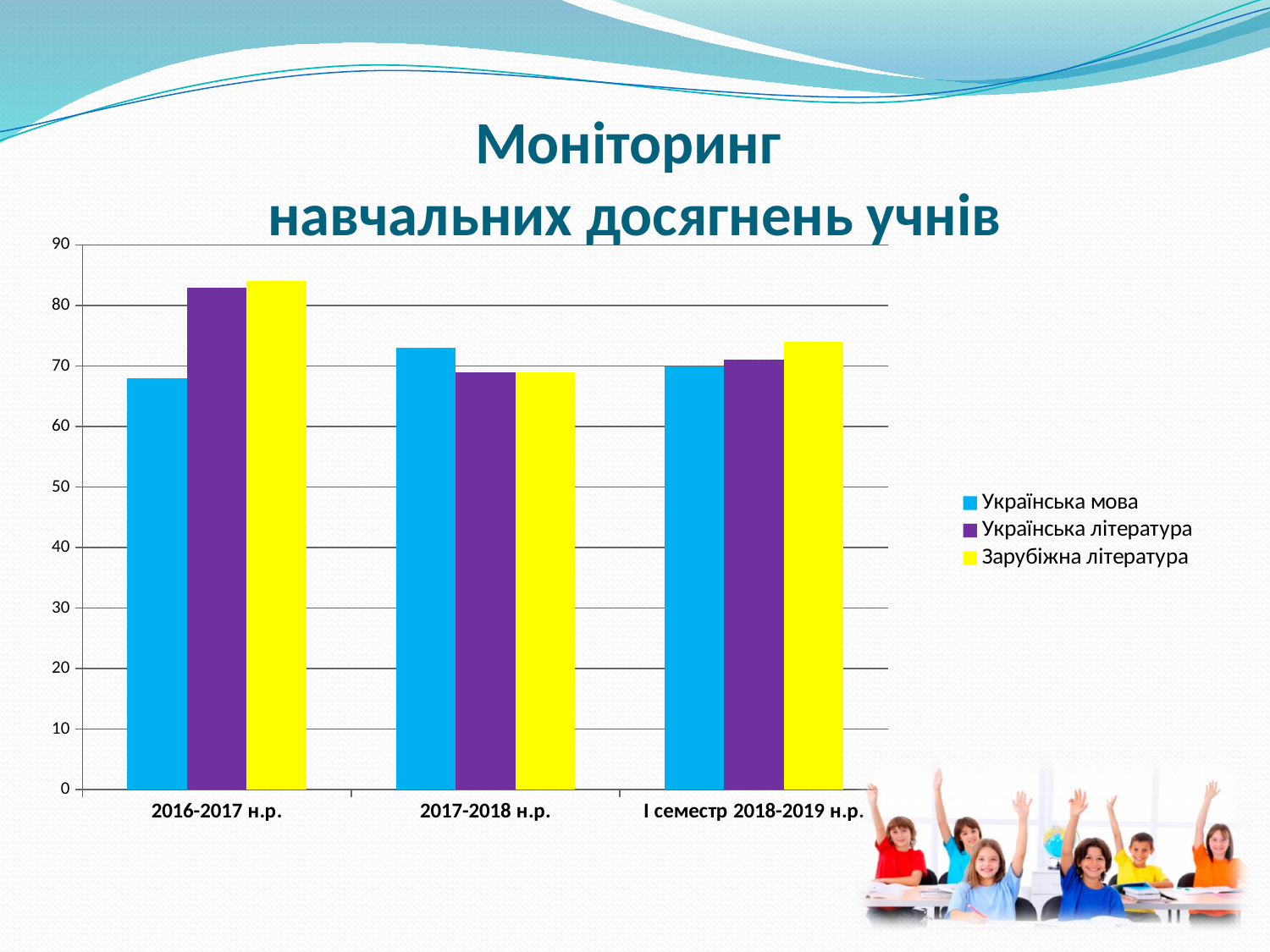
In 2017-2018 н.р., which is larger: Українська мова or Зарубіжна література? Українська мова Is the value for Зарубіжна література in 2016-2017 н.р. greater or less than 80? greater How many categories are shown on the x axis? 3 Is the value for Українська мова in 2017-2018 н.р. greater or less than 70? greater In 2016-2017 н.р., which is larger: Українська мова or Українська література? Українська література What kind of chart is shown on the slide? bar chart Is the value for Українська мова in 2016-2017 н.р. greater or less than 70? less In which period is the value for Зарубіжна література the highest? 2016-2017 н.р. Does the value for Українська література rise or fall from 2016-2017 н.р. to 2017-2018 н.р.? fall In which period is the value for Українська мова the lowest? 2016-2017 н.р. How many series does the legend list? 3